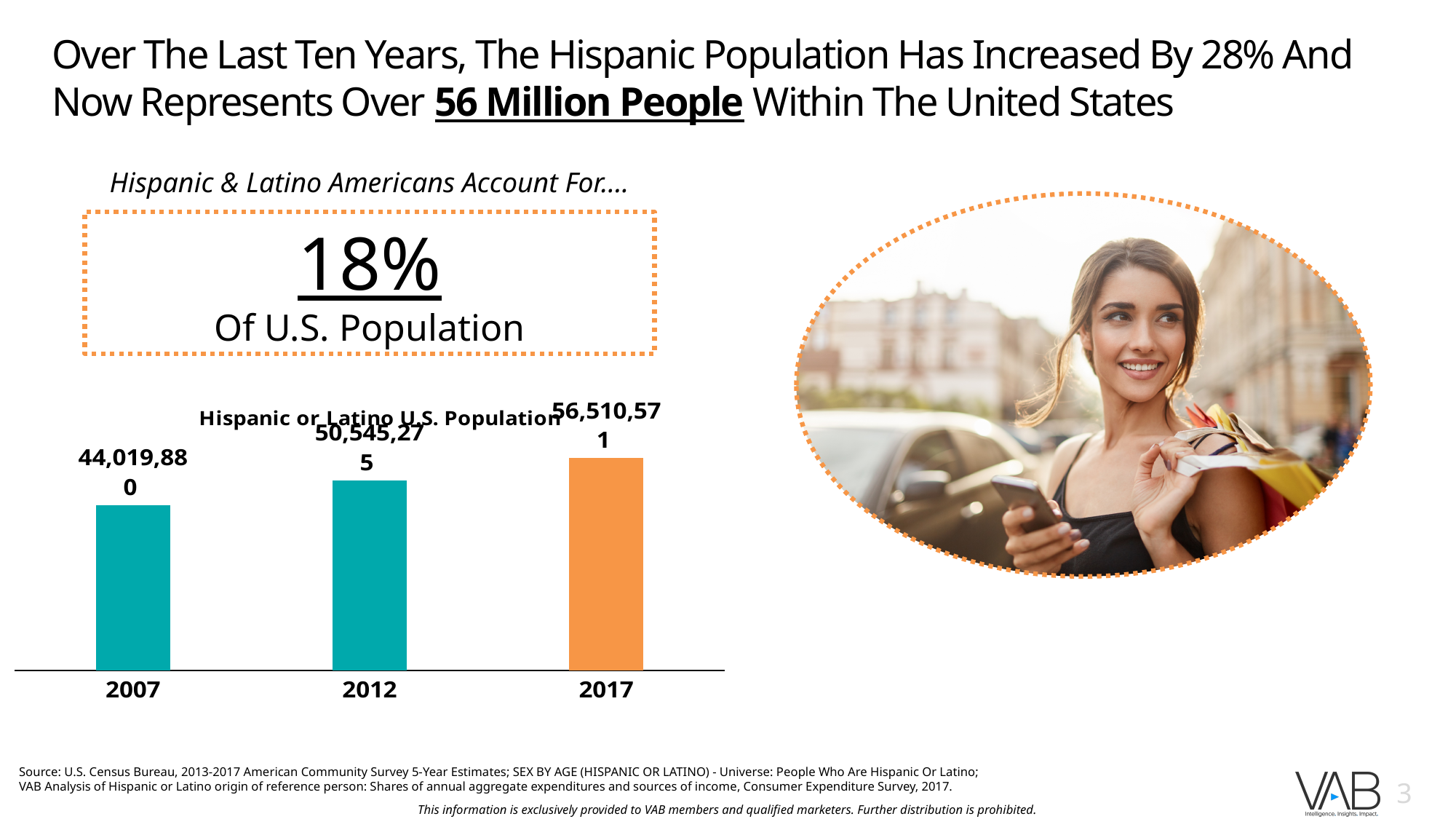
How many years are plotted in the Hispanic or Latino U.S. Population chart? 3 By how much did the Hispanic or Latino U.S. population increase from 2007 to 2017? 12,490,691 What type of chart is used to show the Hispanic or Latino U.S. Population? Bar chart What is the Hispanic or Latino U.S. population shown for 2012? 50,545,275 Which year has a larger Hispanic or Latino U.S. population, 2012 or 2017? 2017 What is the difference between the 2012 and 2007 Hispanic or Latino U.S. population values? 6,525,395 Which year has the highest Hispanic or Latino U.S. population in the chart? 2017 Does the Hispanic or Latino U.S. population rise or fall from 2007 to 2017? Rise Which year has the lowest Hispanic or Latino U.S. population in the chart? 2007 Which year's bar is coloured orange in the Hispanic or Latino U.S. Population chart? 2017 What is the Hispanic or Latino U.S. population shown for 2007? 44,019,880 What is the Hispanic or Latino U.S. population shown for 2017? 56,510,571